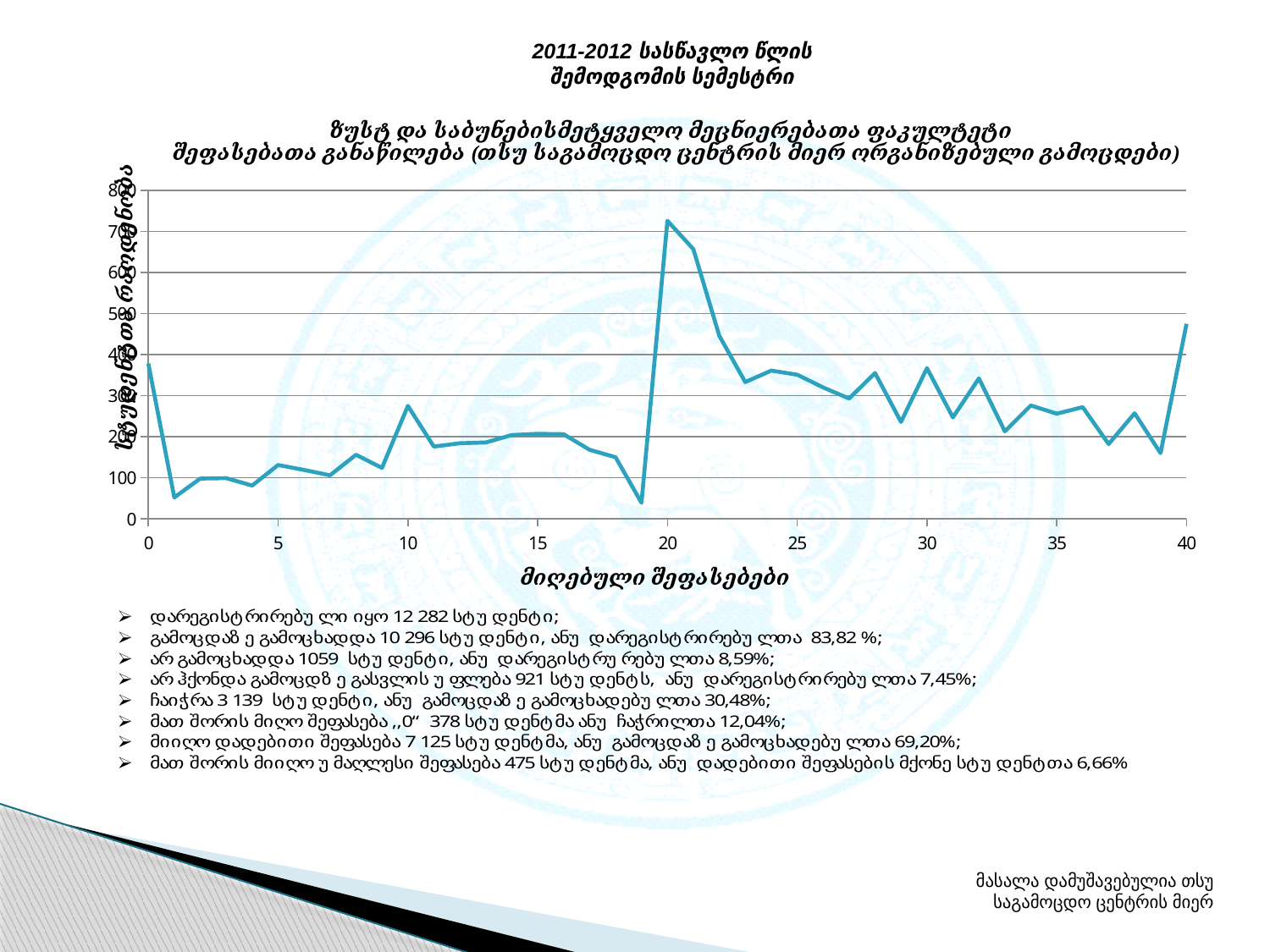
What is the highest value shown on the y axis? 800 Is the value at x = 40 greater or less than 400? greater Is the value at x = 10 greater or less than 200? greater What kind of chart is shown on the slide? line chart Is the value at x = 19 greater or less than 100? less Does the line rise or fall between x = 20 and x = 23? fall At which x-axis value does the line reach its highest point? 20 Which is larger, the value at x = 20 or the value at x = 0? x = 20 What is the title of the x axis? მიღებული შეფასებები